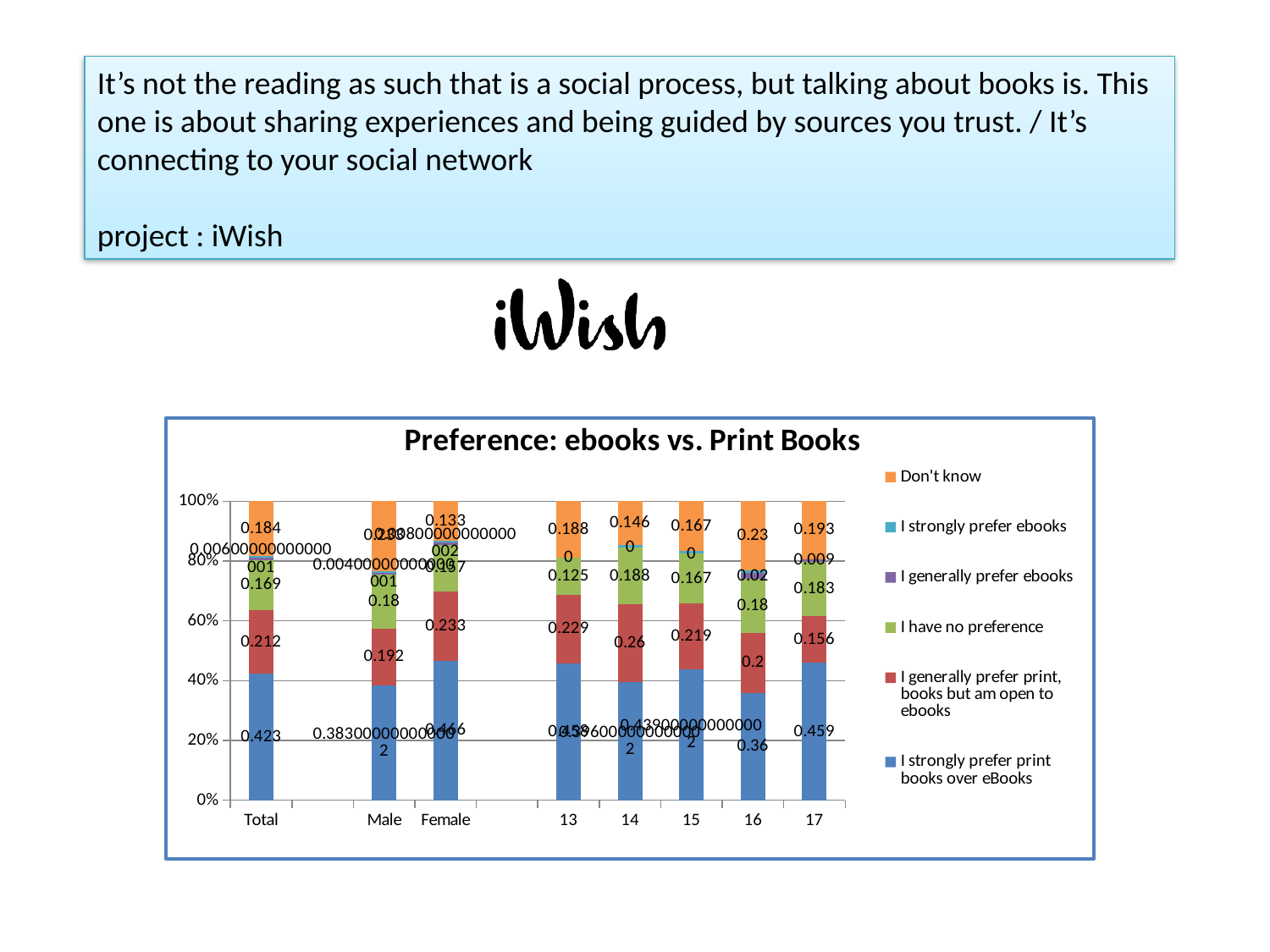
How many categories are shown along the x axis of the chart? 8 Which category has the lowest 'I generally prefer print, books but am open to ebooks' value? 17 What is the value for 'I strongly prefer print books over eBooks' in the Total category? 0.423 What kind of chart is shown on the slide? stacked bar chart What is the 'I generally prefer print, books but am open to ebooks' value for the 14 category? 0.26 What is the 'I have no preference' value for the 17 category? 0.183 Which is larger, the 'I generally prefer print, books but am open to ebooks' value for 14 or for 15? 14 What is the difference between the 'I strongly prefer print books over eBooks' value and the 'I generally prefer print, books but am open to ebooks' value for the 16 category? 0.16 What is the title of the chart? Preference: ebooks vs. Print Books What is the 'Don't know' value for the Total category? 0.184 What is the 'I strongly prefer print books over eBooks' value for the 16 category? 0.36 How many series does the chart's legend list? 6